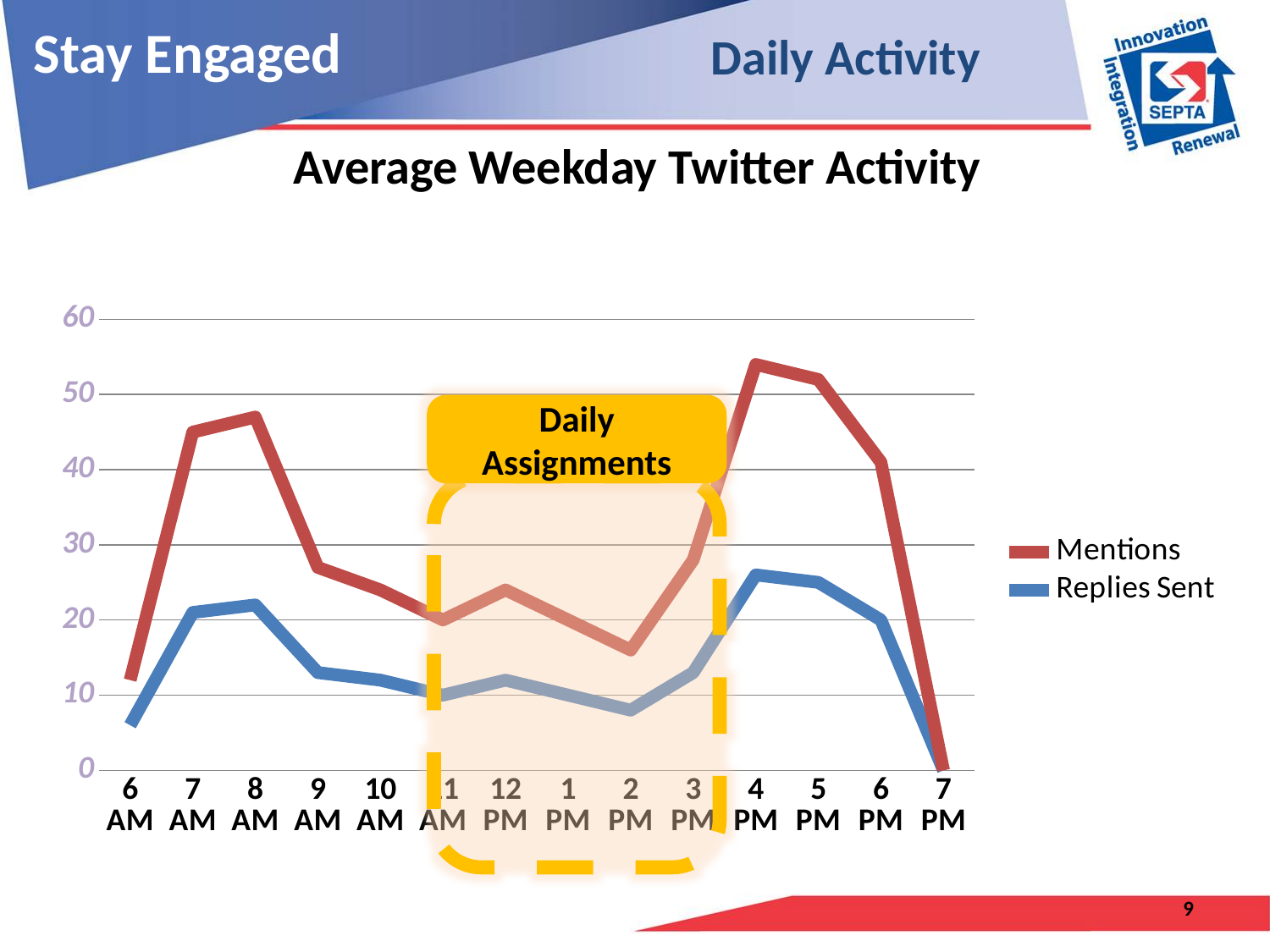
What kind of chart is shown on the slide? Line chart How many series does the legend list? 2 Is the Mentions value at 2 PM greater or less than 20? less How many time points are shown along the x axis? 14 At which time is the Mentions value lowest? 7 PM Do the Mentions values rise or fall from 4 PM to 7 PM? Fall Is the Replies Sent value at 4 PM greater or less than 20? greater What is the title of the chart? Average Weekday Twitter Activity Which is larger at 7 AM, Mentions or Replies Sent? Mentions Is the Replies Sent value at 6 AM greater or less than 10? less Which series is drawn in red? Mentions